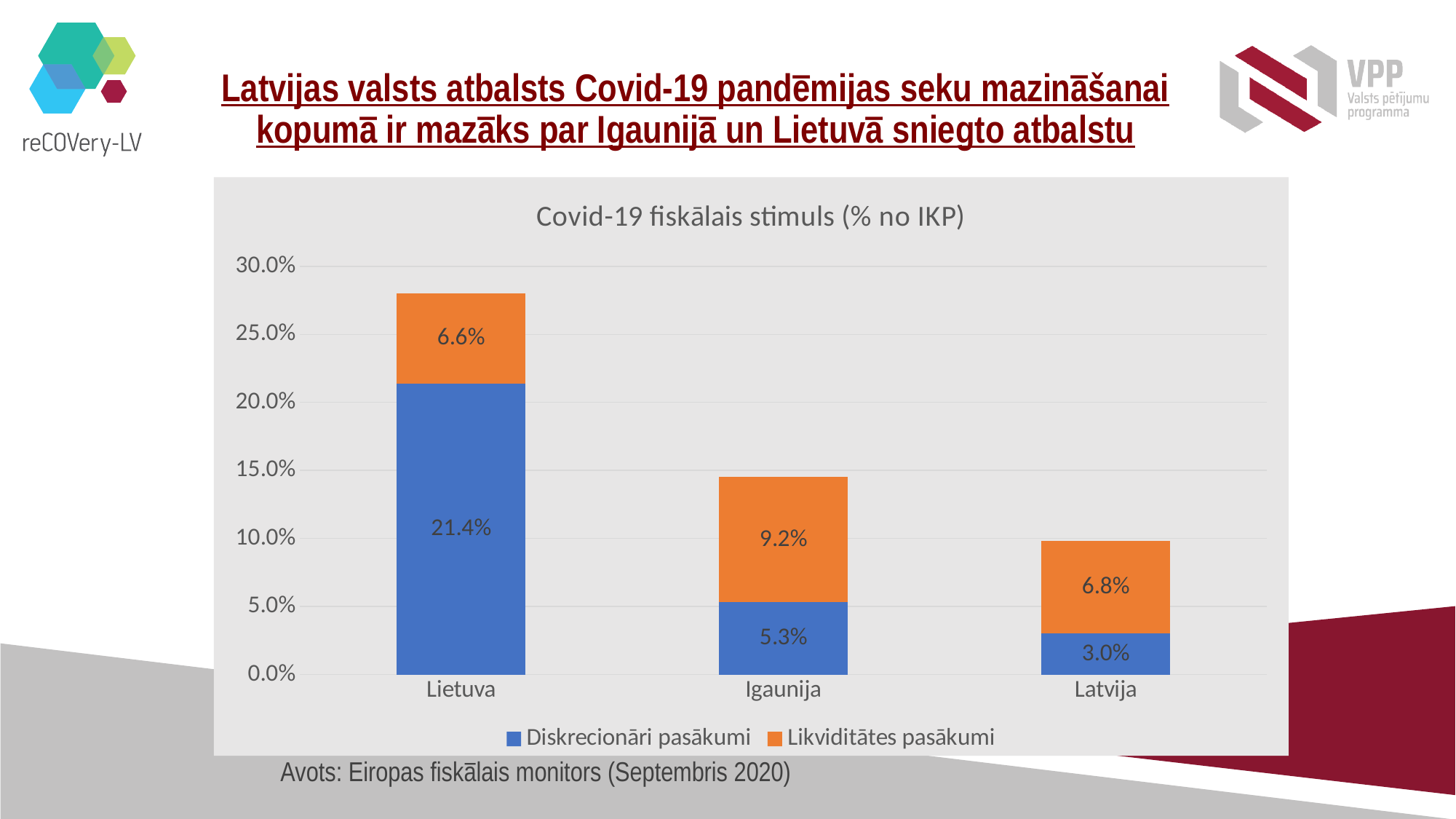
What is the value of Diskrecionāri pasākumi for Lietuva? 21.4% Which is larger: Likviditātes pasākumi for Igaunija or for Latvija? Igaunija What is the total of the stacked bar for Latvija? 9.8% Which country has the highest value for Diskrecionāri pasākumi? Lietuva What is the difference between the Diskrecionāri pasākumi values for Lietuva and Igaunija? 16.1% What is the value of Diskrecionāri pasākumi for Latvija? 3.0% What is the total of the stacked bar for Lietuva? 28.0% What is the value of Likviditātes pasākumi for Igaunija? 9.2% What is the value of Likviditātes pasākumi for Latvija? 6.8% Which country has the lowest value for Likviditātes pasākumi? Lietuva What kind of chart is shown on the slide? Stacked bar chart How many series does the legend list? 2